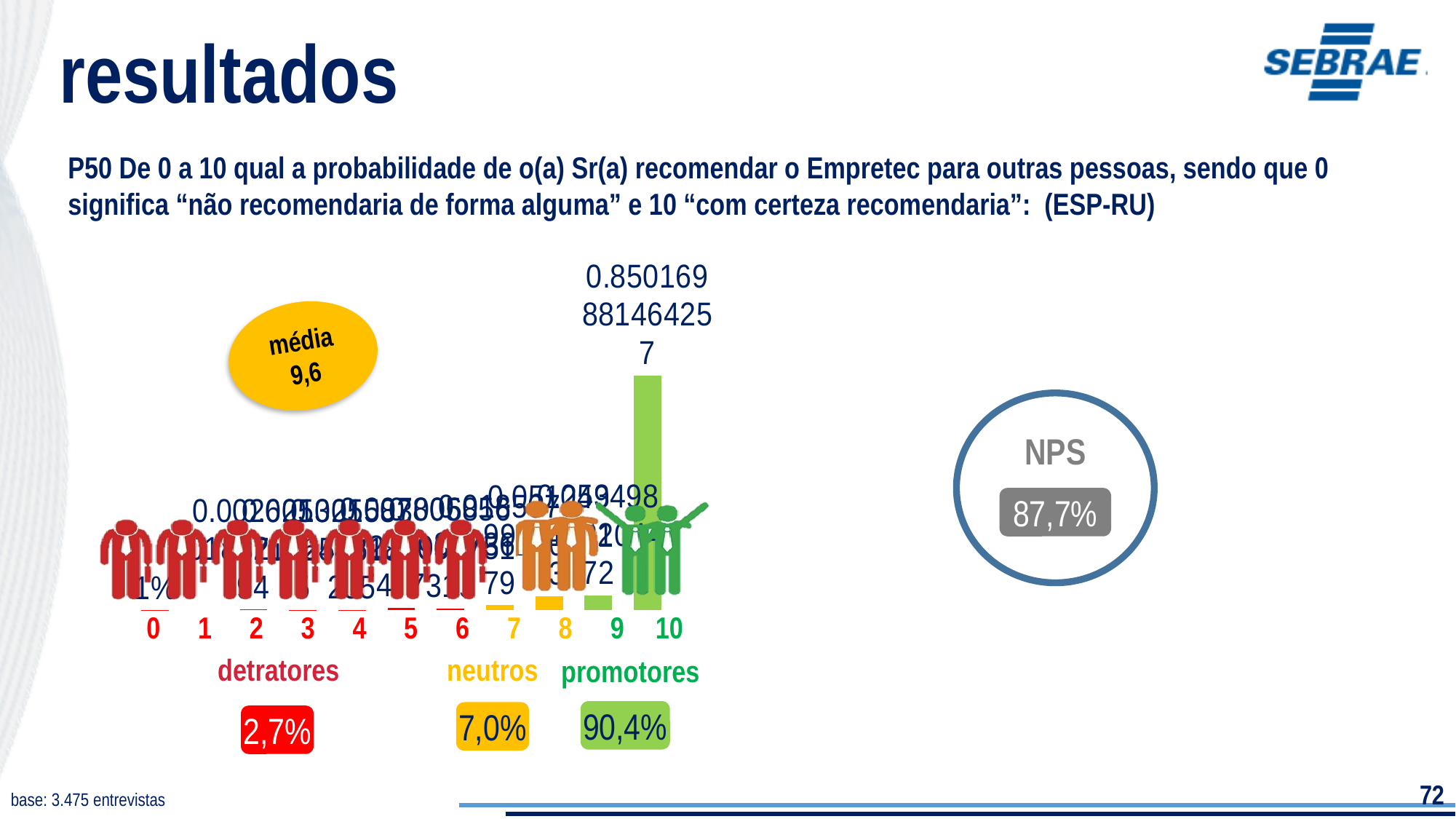
What is the difference between the 'promotores' percentage and the 'neutros' percentage? 83,4% Which group has the larger percentage, 'detratores' or 'neutros'? neutros What is the 'média' (average) value shown in the yellow oval? 9,6 Which bar is taller, the one for score 9 or the one for score 10? 10 What percentage is shown for the 'neutros' group? 7,0% What is the data label printed above the bar for score 10? 0.850169881464257 What kind of chart is used to show the distribution of scores from 0 to 10? bar chart How many score categories are shown along the x axis of the chart? 11 What percentage is shown for the 'detratores' group? 2,7% Which score category has the highest bar in the chart? 10 What percentage is shown for the 'promotores' group? 90,4% What NPS value is shown in the circle on the right of the slide? 87,7%